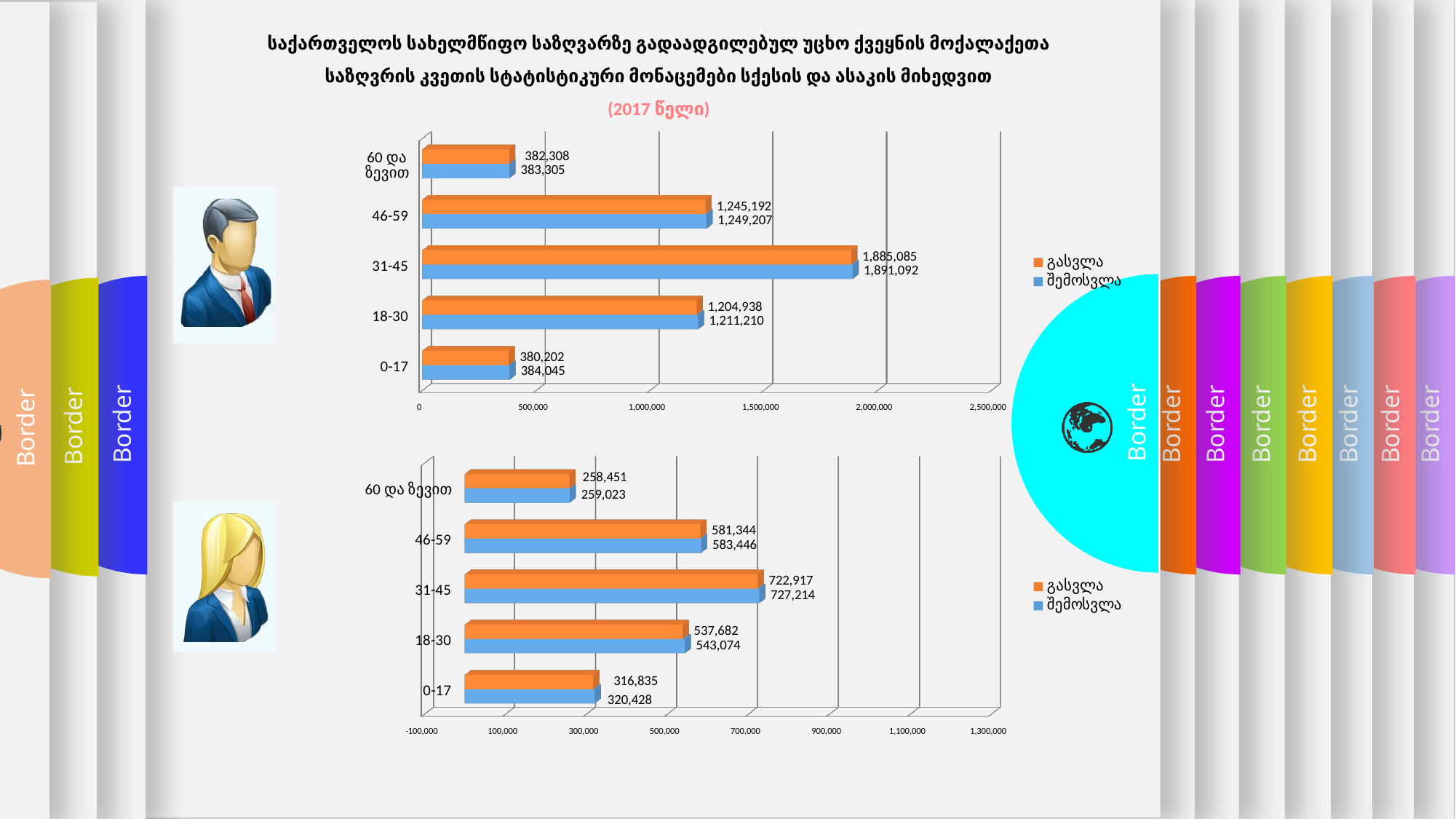
In the bottom chart, what is the difference between the შემოსვლა and გასვლა values for the 31-45 age group? 4,297 How many series does the legend of the bottom chart list? 2 What type of chart is the top chart? Bar chart In the top chart, which age group has the highest გასვლა value? 31-45 In the bottom chart, what is the გასვლა value for the 0-17 age group? 316,835 In the top chart, what is the გასვლა value for the 31-45 age group? 1,885,085 In the bottom chart, what is the შემოსვლა value for the 46-59 age group? 583,446 In the bottom chart, which age group has the lowest შემოსვლა value? 60 და ზევით In the top chart, what is the შემოსვლა value for the 18-30 age group? 1,211,210 How many age groups are shown in the top chart? 5 In the top chart, what is the difference between the შემოსვლა and გასვლა values for the 0-17 age group? 3,843 In the bottom chart, which is larger: the გასვლა value for 18-30 or the გასვლა value for 46-59? 46-59